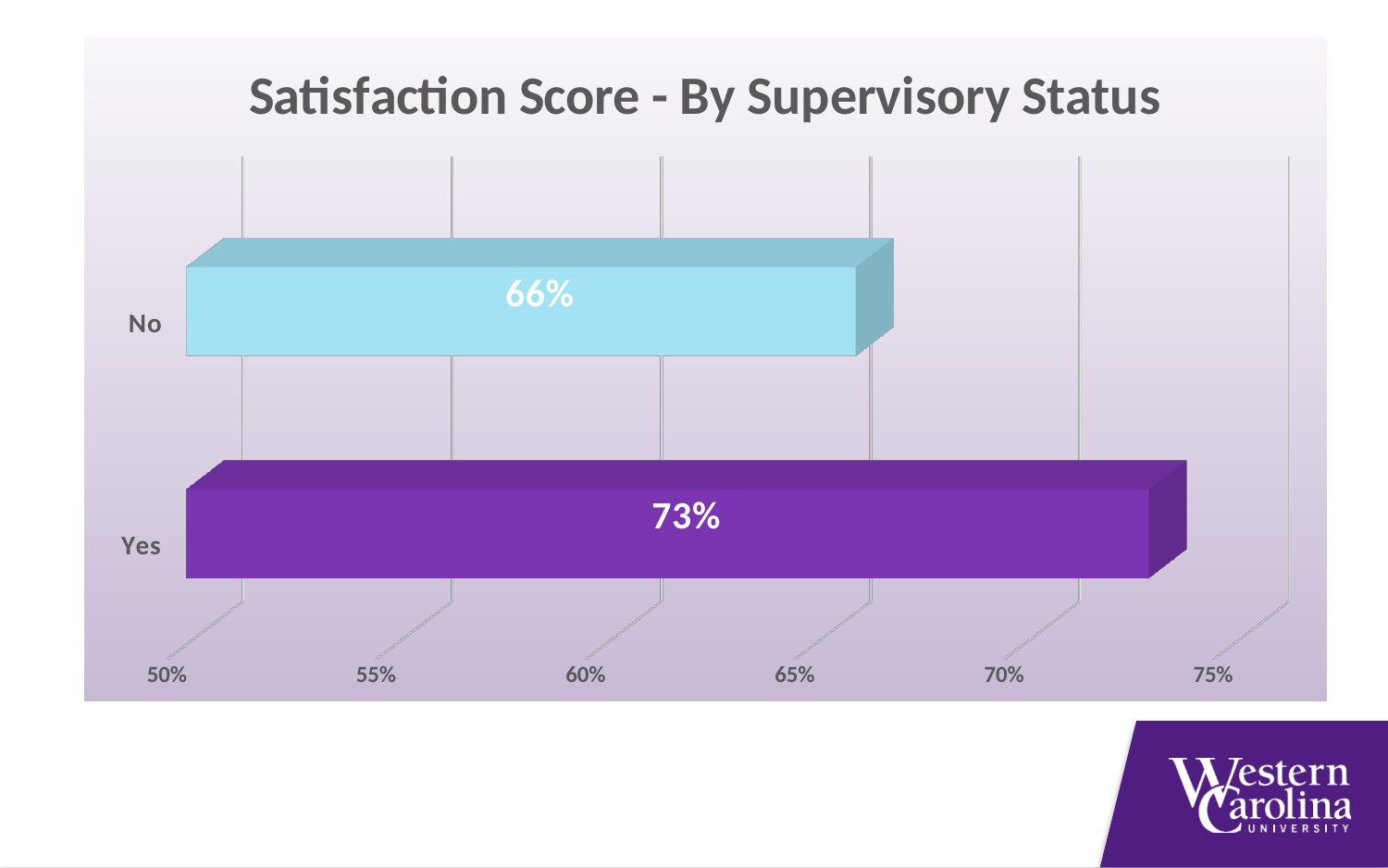
What colour is the bar for the "Yes" category? Purple Is the satisfaction score for "No" greater or less than 70%? less Which has a larger satisfaction score, "Yes" or "No"? Yes What is the difference between the satisfaction scores for "Yes" and "No"? 7% What kind of chart is shown on the slide? Bar chart Is the satisfaction score for "Yes" greater or less than 70%? greater How many categories are shown in the chart? 2 What is the satisfaction score for the "No" category? 66% What is the satisfaction score for the "Yes" category? 73% Which category has the highest satisfaction score? Yes Which category has the lowest satisfaction score? No What is the title of the chart? Satisfaction Score - By Supervisory Status